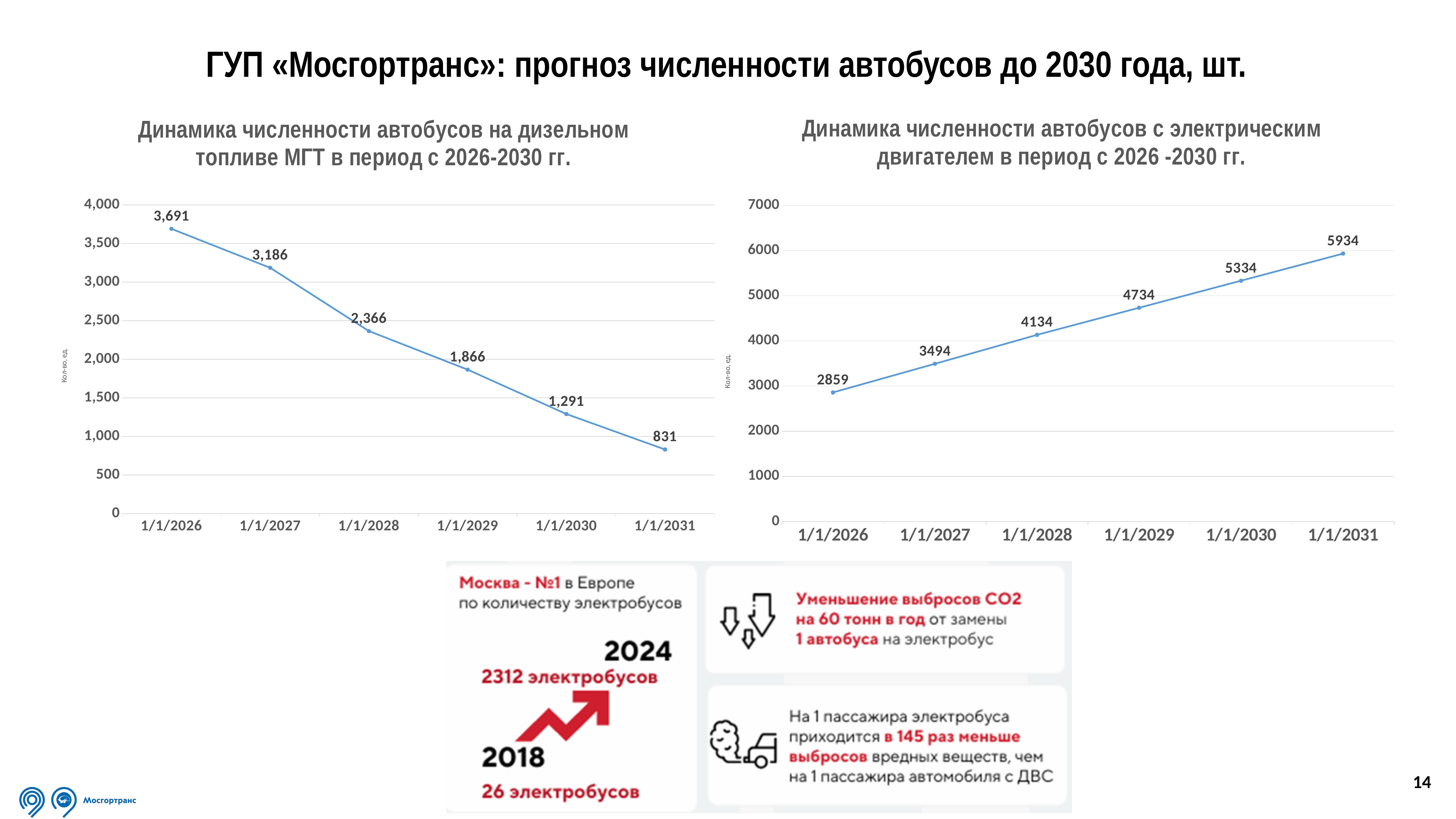
In the right chart (electric buses), what is the value for 1/1/2031? 5934 In the left chart (diesel buses), do the values rise or fall from 1/1/2026 to 1/1/2031? Fall How many data points are plotted in the left chart (diesel buses)? 6 In the right chart (electric buses), is the value for 1/1/2029 larger than the value for 1/1/2027? Yes In the right chart (electric buses), what is the difference between the values for 1/1/2031 and 1/1/2026? 3075 In the left chart (diesel buses), what is the value for 1/1/2026? 3,691 In the right chart (electric buses), what is the value for 1/1/2028? 4134 In the left chart (diesel buses), what is the difference between the values for 1/1/2026 and 1/1/2027? 505 What type of chart is the right chart (electric buses)? Line chart In the left chart (diesel buses), which date has the lowest value? 1/1/2031 In the right chart (electric buses), which date has the highest value? 1/1/2031 In the left chart (diesel buses), what is the value for 1/1/2031? 831